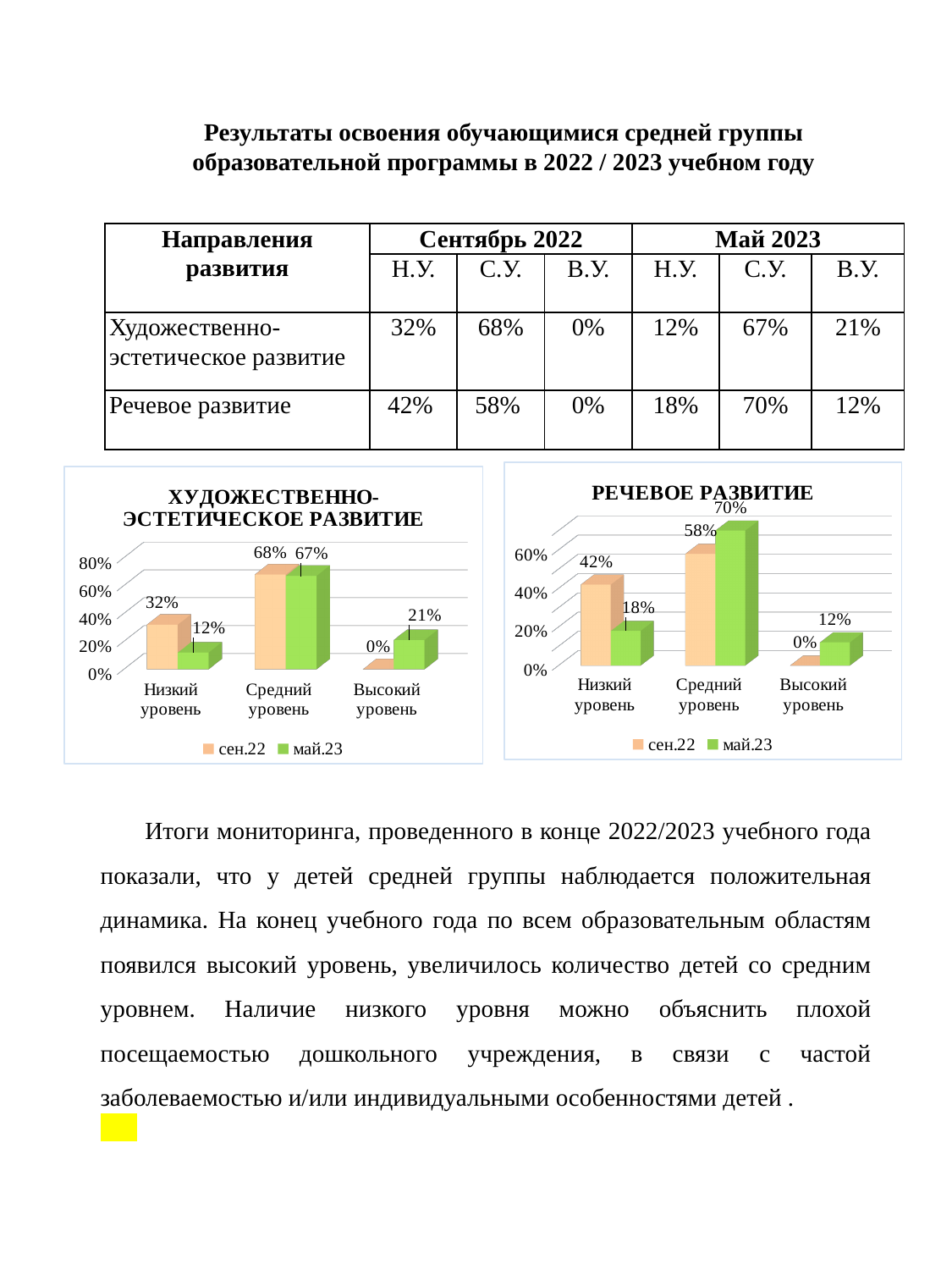
In the chart titled "РЕЧЕВОЕ РАЗВИТИЕ", what is the value for "Средний уровень" in the "май.23" series? 70% In the chart titled "ХУДОЖЕСТВЕННО-ЭСТЕТИЧЕСКОЕ РАЗВИТИЕ", which category has the lowest value in the "май.23" series? Низкий уровень In the chart titled "РЕЧЕВОЕ РАЗВИТИЕ", what is the difference between the "сен.22" and "май.23" values for "Низкий уровень"? 24% In the chart titled "ХУДОЖЕСТВЕННО-ЭСТЕТИЧЕСКОЕ РАЗВИТИЕ", what is the value for "Высокий уровень" in the "май.23" series? 21% What kind of chart is the chart titled "РЕЧЕВОЕ РАЗВИТИЕ"? bar chart In the chart titled "РЕЧЕВОЕ РАЗВИТИЕ", what is the value for "Высокий уровень" in the "сен.22" series? 0% How many categories are shown on the x axis of the chart titled "ХУДОЖЕСТВЕННО-ЭСТЕТИЧЕСКОЕ РАЗВИТИЕ"? 3 How many series does the legend of the chart titled "РЕЧЕВОЕ РАЗВИТИЕ" list? 2 In the chart titled "РЕЧЕВОЕ РАЗВИТИЕ", which category has the highest value in the "сен.22" series? Средний уровень In the chart titled "ХУДОЖЕСТВЕННО-ЭСТЕТИЧЕСКОЕ РАЗВИТИЕ", what is the value for "Низкий уровень" in the "сен.22" series? 32% In the chart titled "РЕЧЕВОЕ РАЗВИТИЕ", is the "май.23" value for "Средний уровень" greater or less than 60%? greater In the chart titled "ХУДОЖЕСТВЕННО-ЭСТЕТИЧЕСКОЕ РАЗВИТИЕ", which is larger for "Средний уровень": the "сен.22" value or the "май.23" value? сен.22